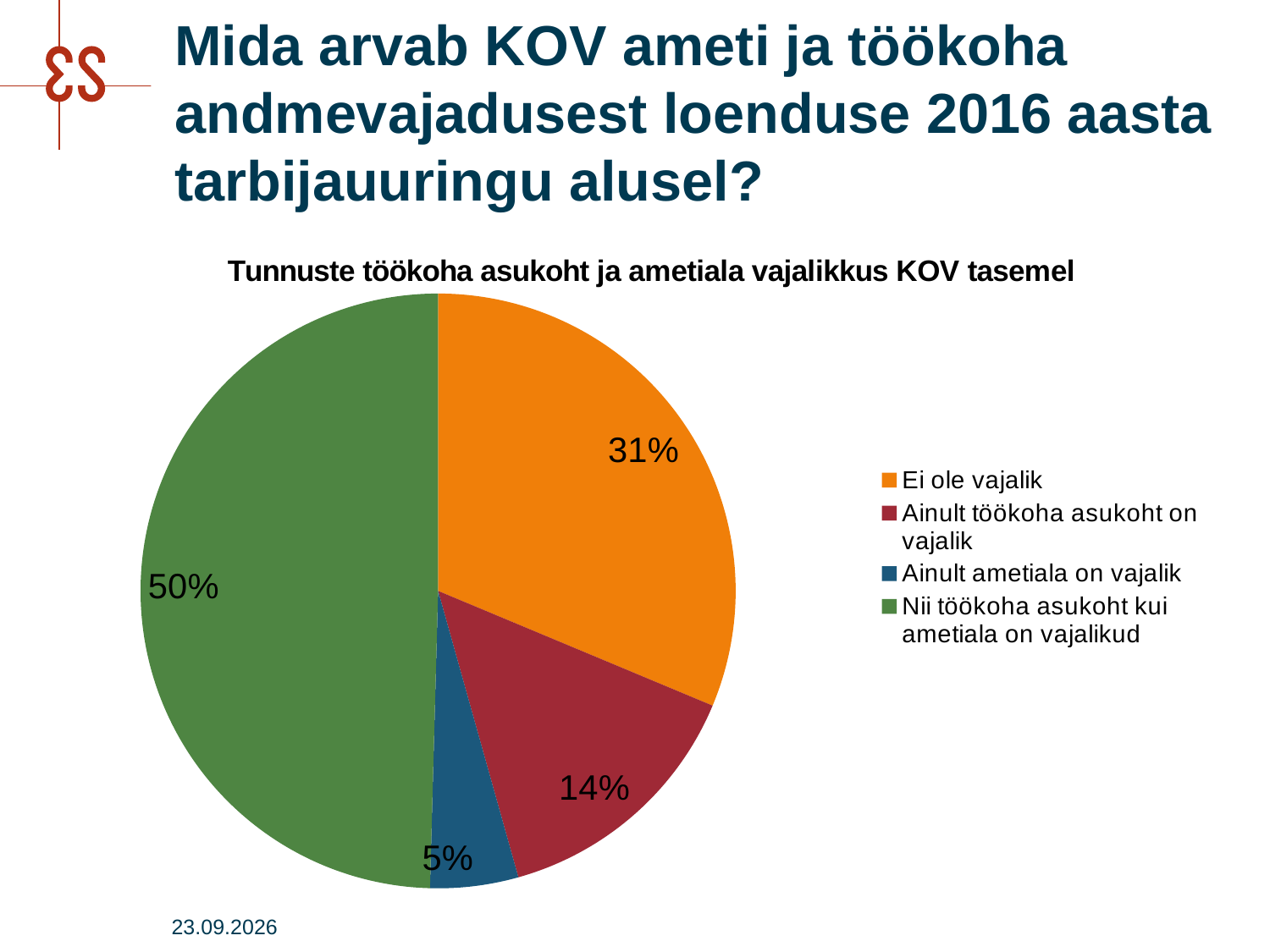
What kind of chart is shown on the slide? pie chart What is the title of the chart? Tunnuste töökoha asukoht ja ametiala vajalikkus KOV tasemel What is the share for "Ainult töökoha asukoht on vajalik"? 14% What colour is the slice for "Ei ole vajalik"? orange What is the share for "Ainult ametiala on vajalik"? 5% What is the share for "Nii töökoha asukoht kui ametiala on vajalikud"? 50% Which is larger: the share for "Ei ole vajalik" or the share for "Ainult töökoha asukoht on vajalik"? Ei ole vajalik Which category has the smallest slice of the pie? Ainult ametiala on vajalik How many categories does the pie chart have? 4 Which category has the largest slice of the pie? Nii töökoha asukoht kui ametiala on vajalikud What is the share for "Ei ole vajalik"? 31% What is the difference in percentage points between "Ei ole vajalik" and "Ainult töökoha asukoht on vajalik"? 17